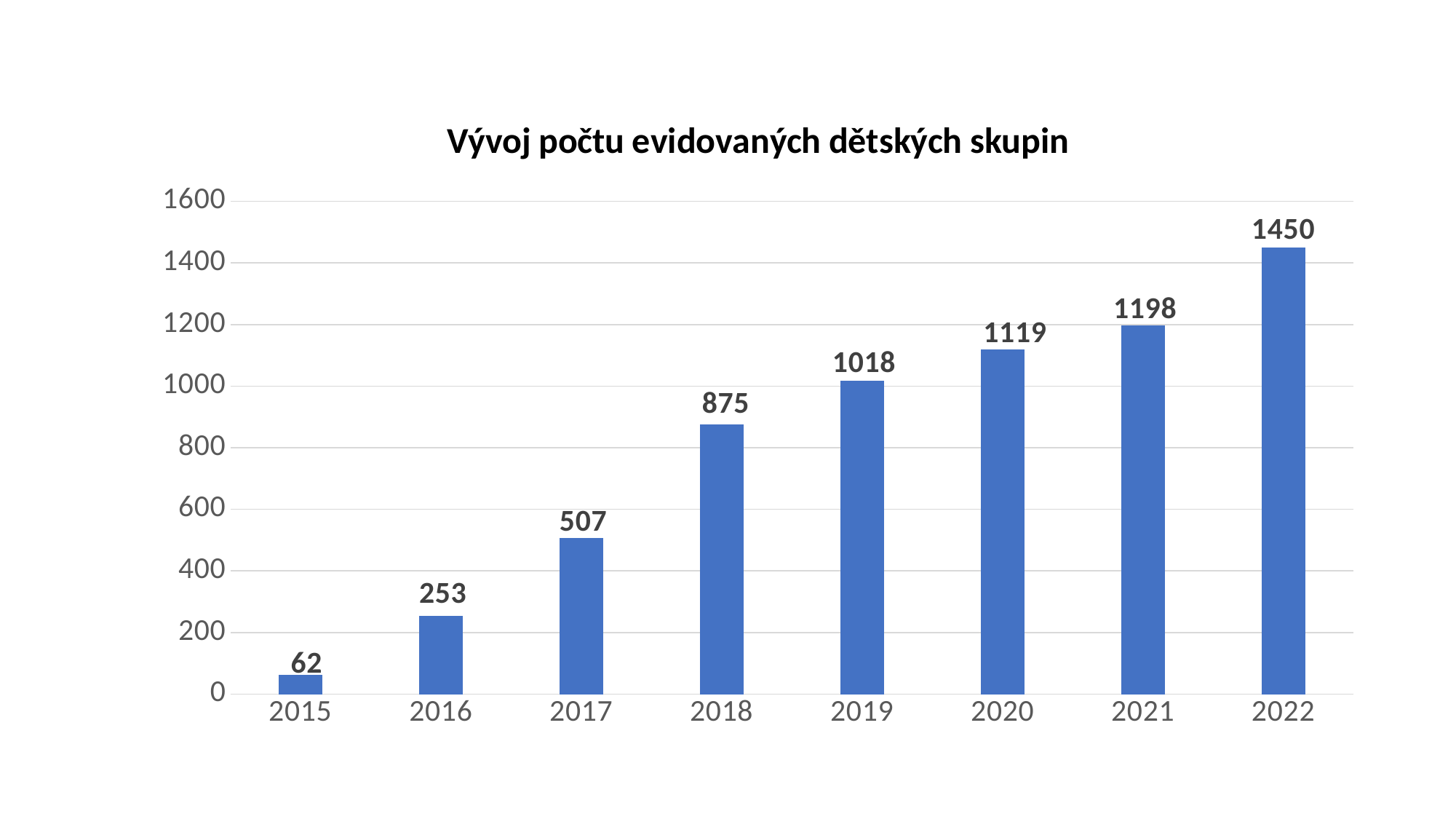
What is the difference between the values for 2017 and 2016? 254 What is the value for 2018? 875 Is the value for 2018 greater or less than 1000? less Which is larger, the value for 2019 or the value for 2020? 2020 How many years are shown on the x axis? 8 Do the values rise or fall from 2015 to 2022? rise What kind of chart is shown on the slide? bar chart What is the difference between the values for 2022 and 2021? 252 What is the value for 2021? 1198 Which year has the highest value? 2022 Which year has the lowest value? 2015 What is the value for 2015? 62